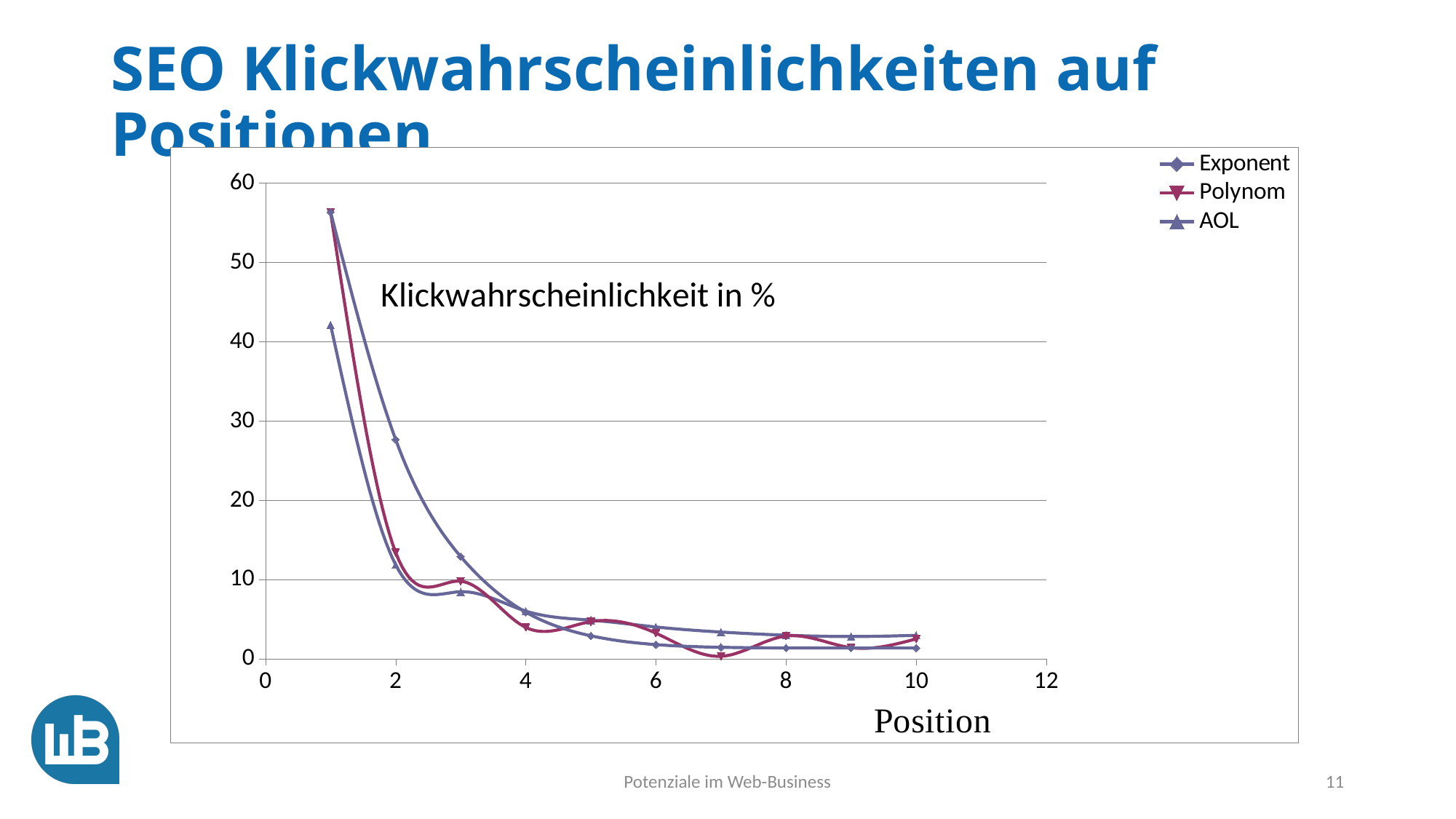
Is the value for AOL at position 1 greater or less than 50? less Do the values of the Exponent series rise or fall as the position increases? fall At which position does the Exponent series reach its highest value? 1 Is the value for Polynom at position 2 greater or less than 10? greater Is the value for Exponent at position 1 greater or less than 50? greater At position 2, which series has the larger value, Exponent or AOL? Exponent Which series are listed in the legend? Exponent, Polynom, AOL What is the label of the x axis? Position How many positions (data points) are plotted for each series? 10 What kind of chart is shown on the slide? line chart How many series does the legend list? 3